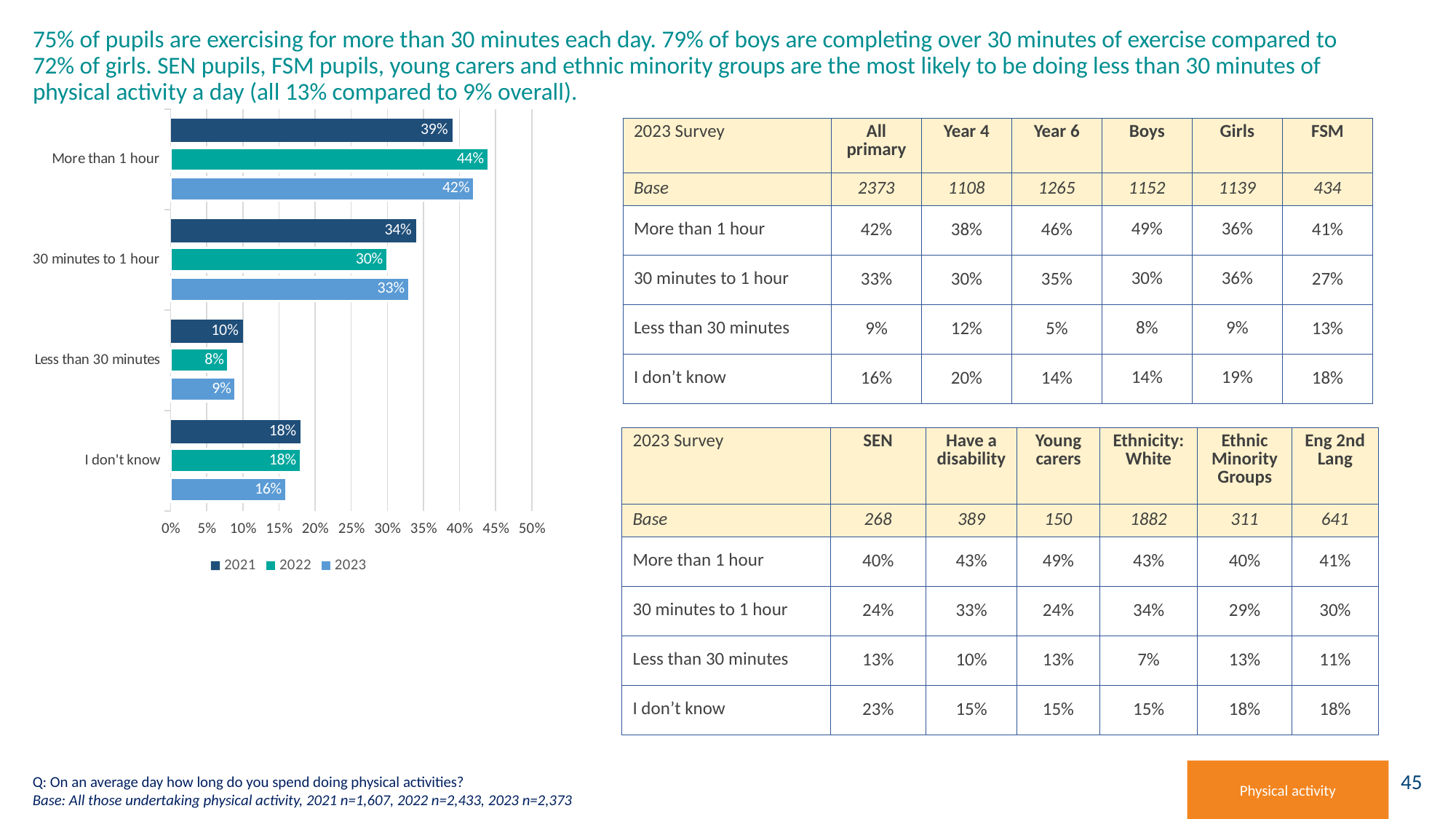
What is the 2023 value for '30 minutes to 1 hour' in the bar chart? 33% Which category has the lowest 2022 value in the bar chart? Less than 30 minutes What type of chart is shown on the slide? bar chart In the bar chart, is the 2021 value for '30 minutes to 1 hour' larger or smaller than the 2022 value? larger How many categories are shown on the bar chart? 4 What is the 2022 value for 'More than 1 hour' in the bar chart? 44% Is the 2023 value for 'I don't know' in the bar chart greater or less than 20%? less What is the difference between the 2022 and 2021 values for 'More than 1 hour' in the bar chart? 5% What is the 2021 value for 'Less than 30 minutes' in the bar chart? 10% Which category has the highest 2023 value in the bar chart? More than 1 hour Which years are listed in the bar chart legend? 2021, 2022, 2023 How many series does the bar chart legend list? 3